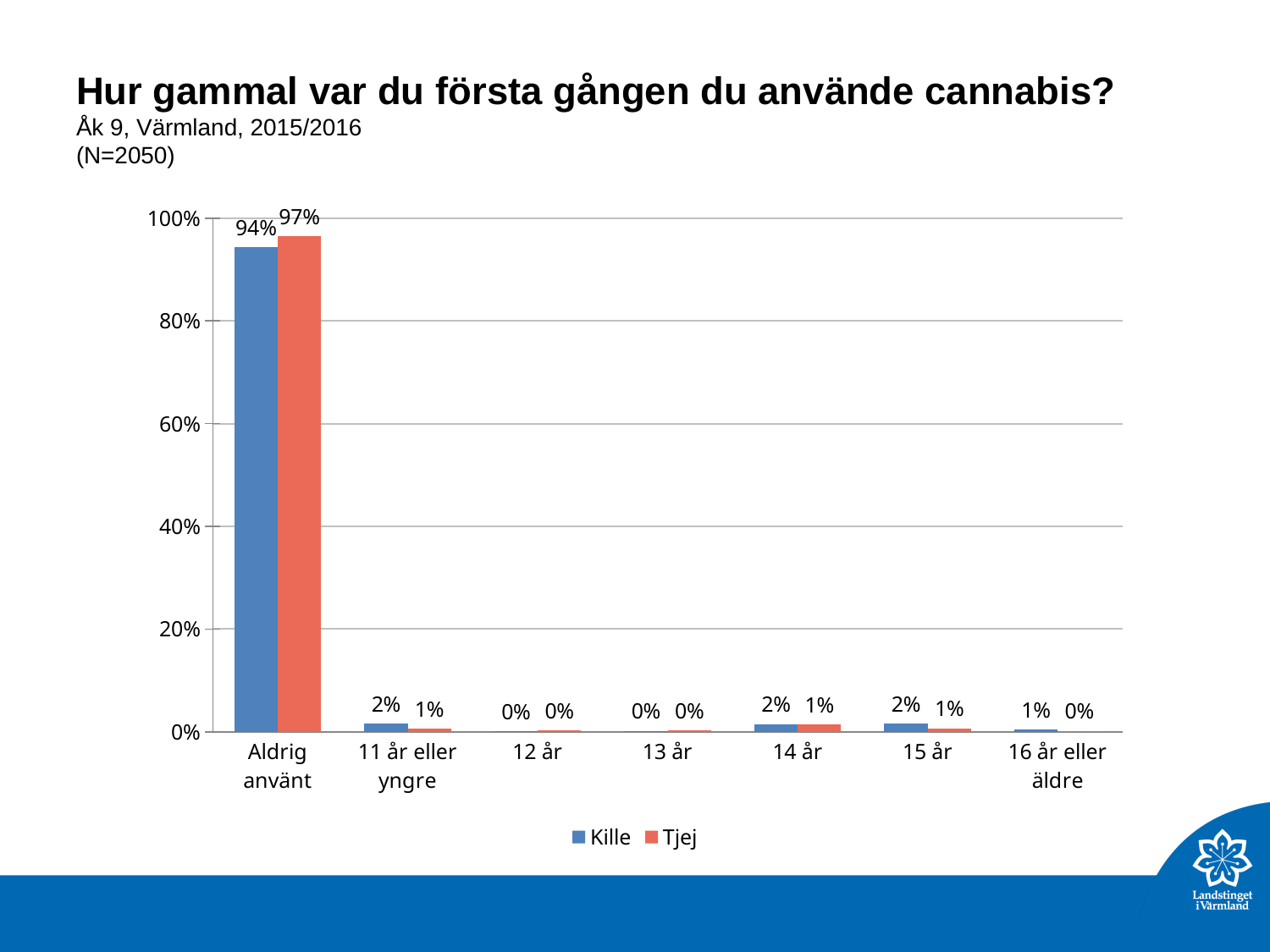
What is the value for Tjej in the 'Aldrig använt' category? 97% What is the difference between the Tjej and Kille values in the 'Aldrig använt' category? 3% What is the value for Kille in the '16 år eller äldre' category? 1% In the 'Aldrig använt' category, which series has the larger value, Kille or Tjej? Tjej What is the value for Tjej in the '15 år' category? 1% Is the value for Kille in the 'Aldrig använt' category greater or less than 80%? greater What kind of chart is shown on the slide? Bar chart How many categories are shown on the x axis? 7 Which category has the highest value for Tjej? Aldrig använt How many series does the legend list? 2 What is the value for Kille in the '11 år eller yngre' category? 2% What is the value for Kille in the 'Aldrig använt' category? 94%